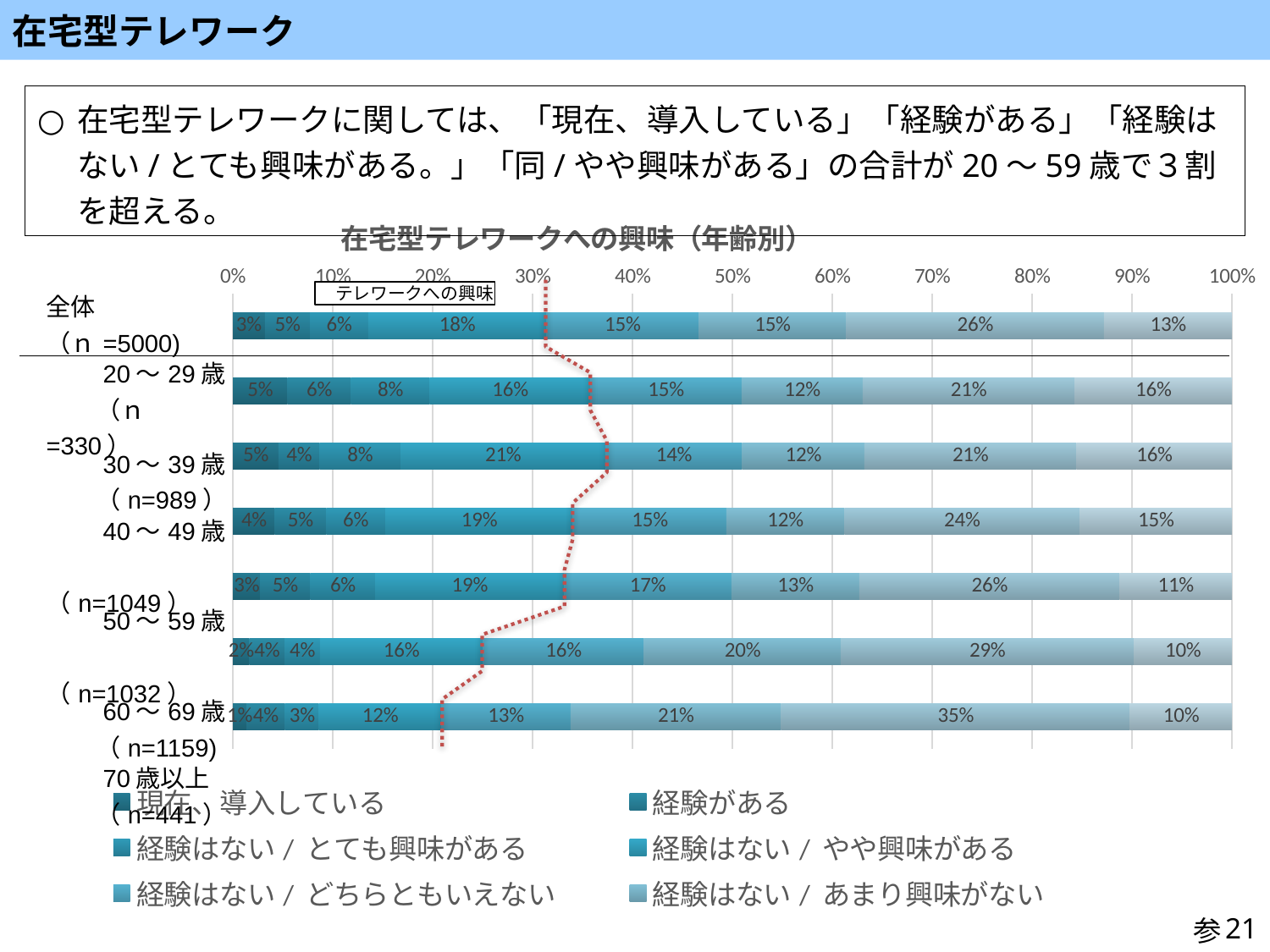
What is the value of the 「現在、導入している」 segment for 20～29歳? 5% How many age-group bars (including 全体) are plotted in the chart? 7 Does the 「現在、導入している」 value generally rise or fall as the age groups go from 20～29歳 to 70歳以上? Fall What is the sample size (n) shown for 全体? 5000 What type of chart is shown on the slide? Stacked bar chart Which age group has the highest value for 「経験はない / とても興味がある」: 20～29歳 or 70歳以上? 20～29歳 What is the value of the 「経験はない / やや興味がある」 segment for 30～39歳? 21% What is the difference between the 「経験はない / やや興味がある」 values for 30～39歳 (21%) and 70歳以上 (12%)? 9% What is the title of the chart? 在宅型テレワークへの興味（年齢別） What is the value of the 「経験はない / やや興味がある」 segment for 全体 (n=5000)? 18% What is the largest single segment value shown in the 70歳以上 bar? 35% What is the value of the 「経験はない / あまり興味がない」 segment for 60～69歳? 20%